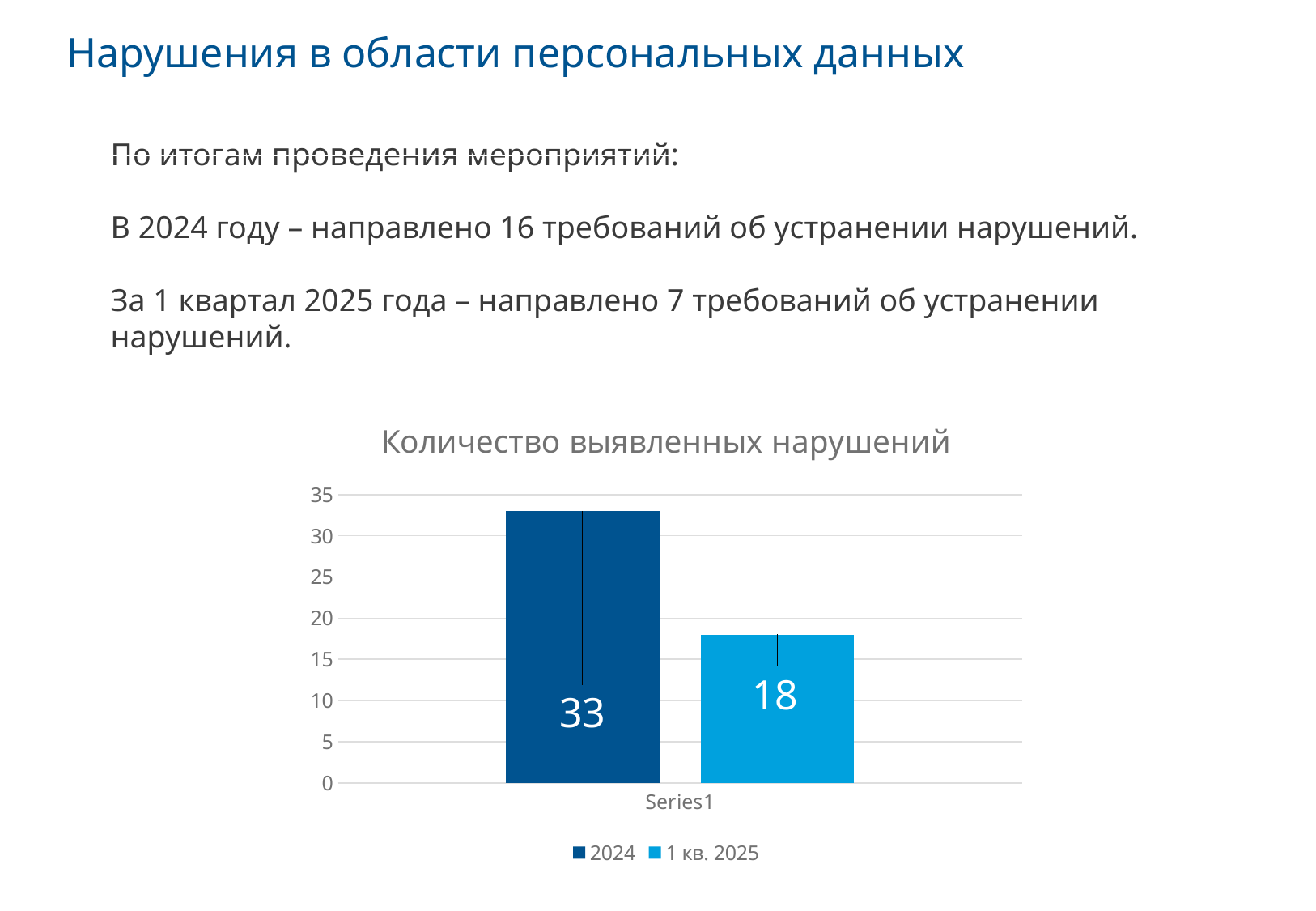
What is the title of the chart? Количество выявленных нарушений How many series does the legend list? 2 What kind of chart is shown on the slide? bar chart Which series has the highest value in the chart? 2024 Which series has the lowest value in the chart? 1 кв. 2025 Which is larger, the value for 2024 or the value for 1 кв. 2025? 2024 What is the difference between the values for 2024 and 1 кв. 2025? 15 What is the value for 2024 in the chart? 33 What is the value for 1 кв. 2025 in the chart? 18 What is the highest value shown on the vertical axis of the chart? 35 Is the value for 1 кв. 2025 greater or less than 20? less Is the value for 2024 greater or less than 30? greater